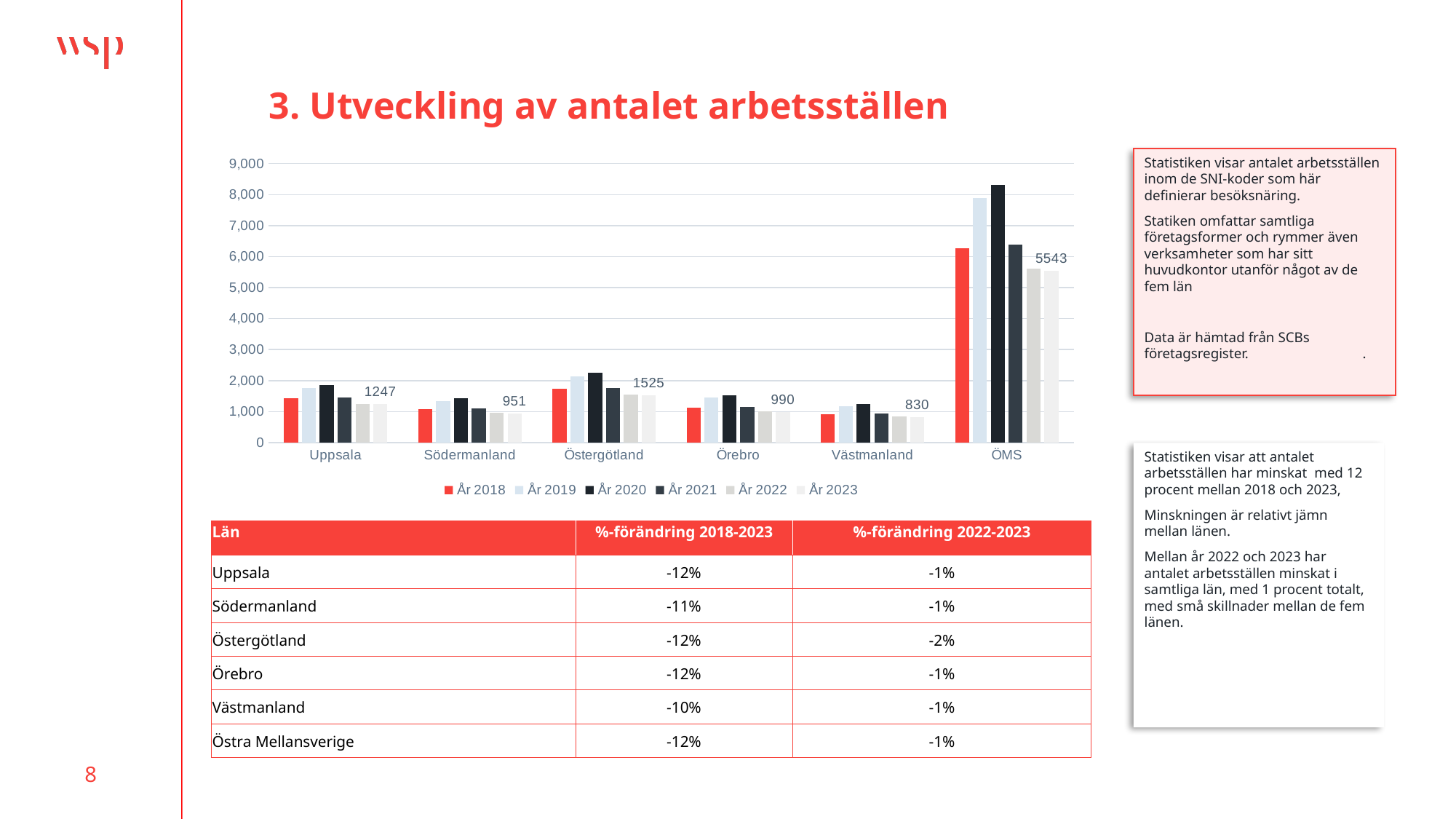
How many categories are shown on the x axis of the chart? 6 What is the difference between the År 2023 values for Östergötland and Uppsala? 278 Which is larger in År 2023: Örebro or Södermanland? Örebro Which category has the highest value in År 2023? ÖMS What is the value for Västmanland in År 2023? 830 What kind of chart is shown on the slide? Bar chart Is the value for ÖMS in År 2020 greater or less than 8,000? greater How many series does the chart legend list? 6 Which category has the lowest value in År 2023? Västmanland Is the value for Uppsala in År 2018 greater or less than 2,000? less What is the value for Östergötland in År 2023? 1525 What is the value for ÖMS in År 2023? 5543